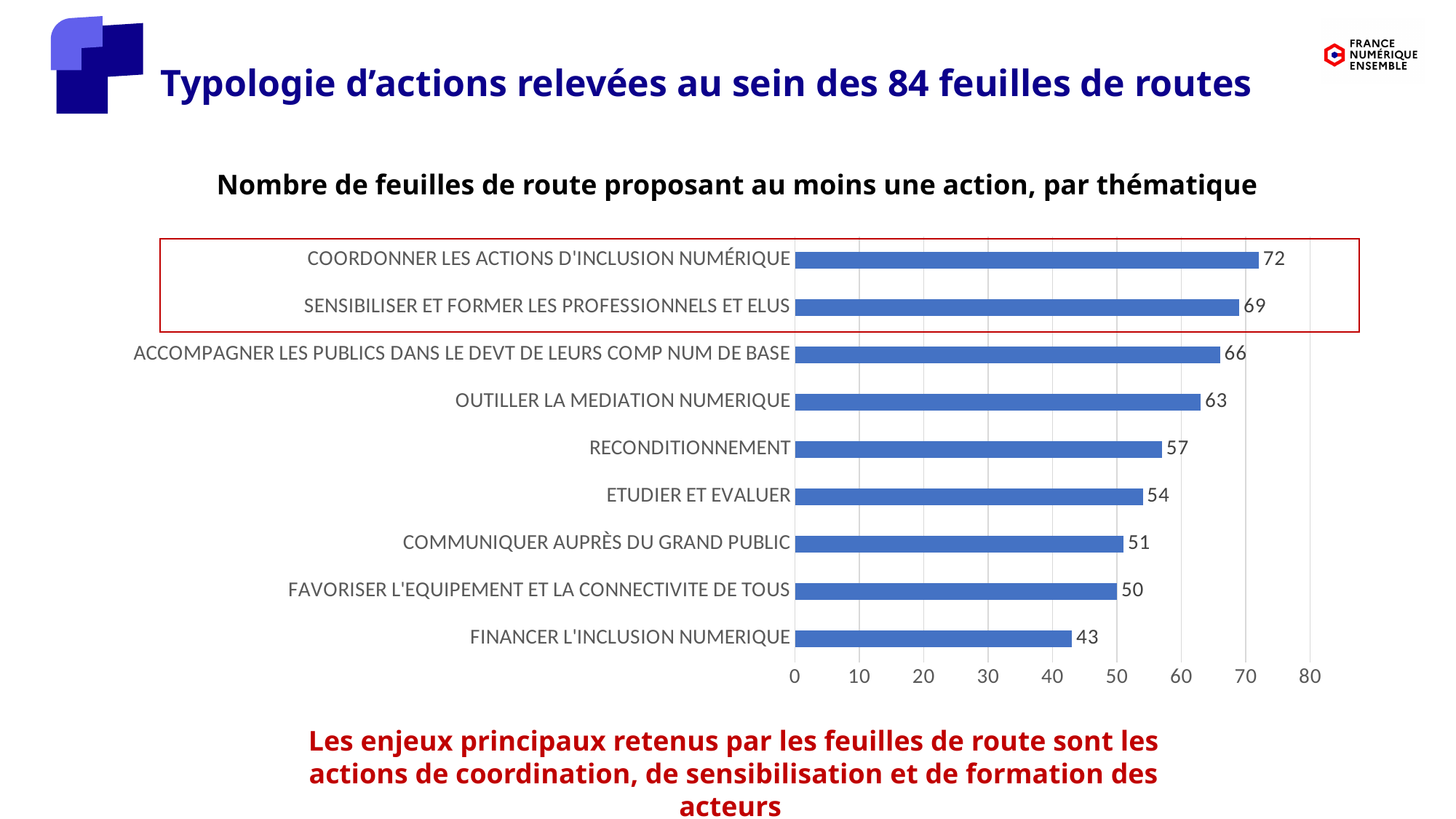
What is the value for FINANCER L'INCLUSION NUMERIQUE? 43 Which category has the lowest value? FINANCER L'INCLUSION NUMERIQUE What is the difference between the values for OUTILLER LA MEDIATION NUMERIQUE and ETUDIER ET EVALUER? 9 What is the value for COORDONNER LES ACTIONS D'INCLUSION NUMÉRIQUE? 72 How many categories are shown in the chart? 9 What is the difference between the values for COORDONNER LES ACTIONS D'INCLUSION NUMÉRIQUE and FINANCER L'INCLUSION NUMERIQUE? 29 Which category has the highest value? COORDONNER LES ACTIONS D'INCLUSION NUMÉRIQUE Which is larger: the value for RECONDITIONNEMENT or the value for COMMUNIQUER AUPRÈS DU GRAND PUBLIC? RECONDITIONNEMENT Is the value for ACCOMPAGNER LES PUBLICS DANS LE DEVT DE LEURS COMP NUM DE BASE greater or less than 60? greater What kind of chart is shown on the slide? bar chart What is the title of the chart? Nombre de feuilles de route proposant au moins une action, par thématique What is the value for RECONDITIONNEMENT? 57